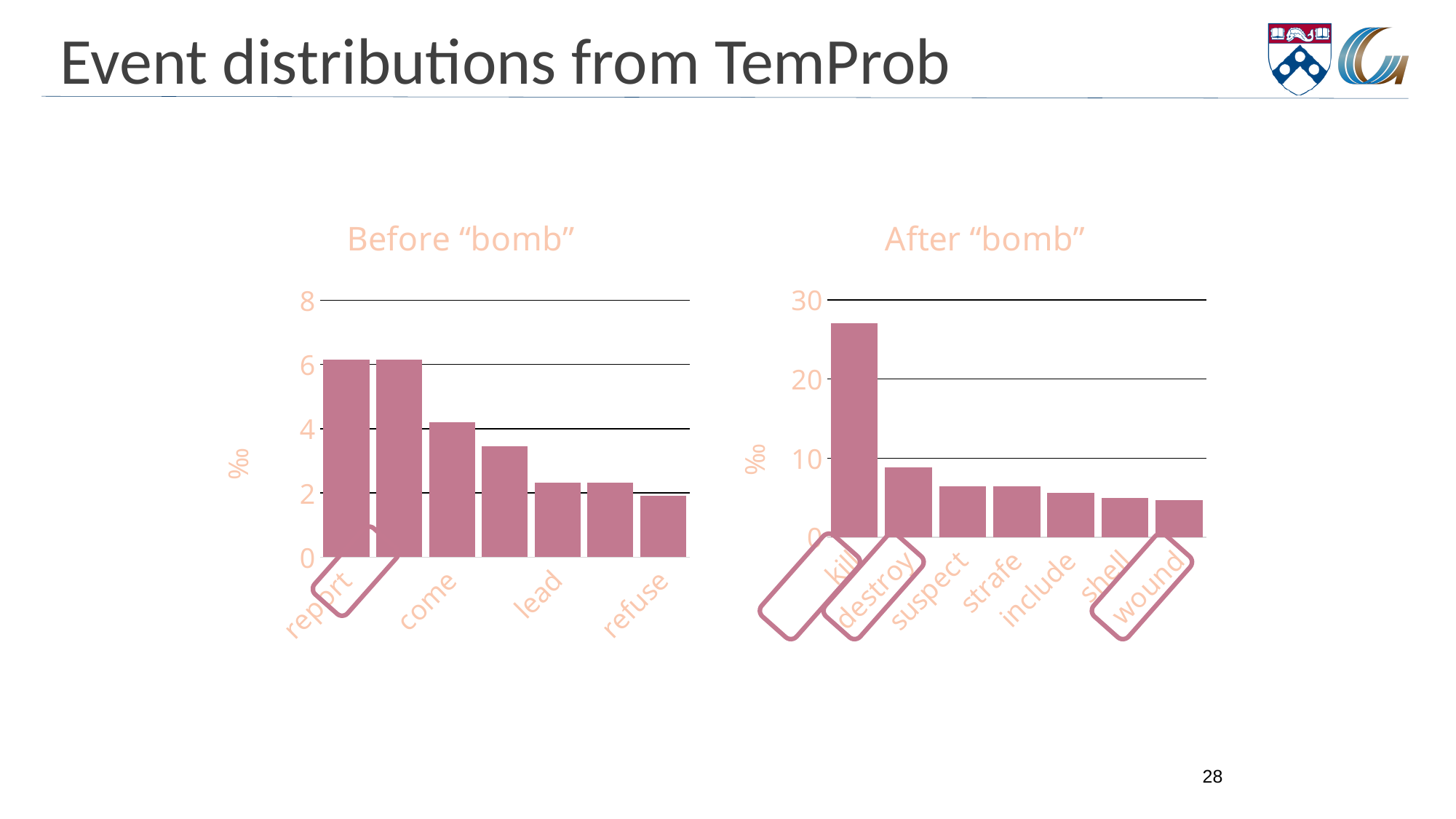
How many bars are plotted in the "After "bomb"" chart? 7 How many bars are plotted in the "Before "bomb"" chart? 7 What kind of chart is the "Before "bomb"" chart? bar chart In the "Before "bomb"" chart, is the value for come greater or less than 6? less In the "Before "bomb"" chart, is the value for report greater or less than 4? greater In the "After "bomb"" chart, which category has the highest value? kill In the "After "bomb"" chart, is the value for destroy greater or less than 10? less What unit is shown on the y axis of the "Before "bomb"" chart? ‰ In the "After "bomb"" chart, which is larger, the value for kill or the value for destroy? kill In the "After "bomb"" chart, do the values rise or fall from left to right along the x axis? fall In the "Before "bomb"" chart, which labelled category has the lowest value? refuse